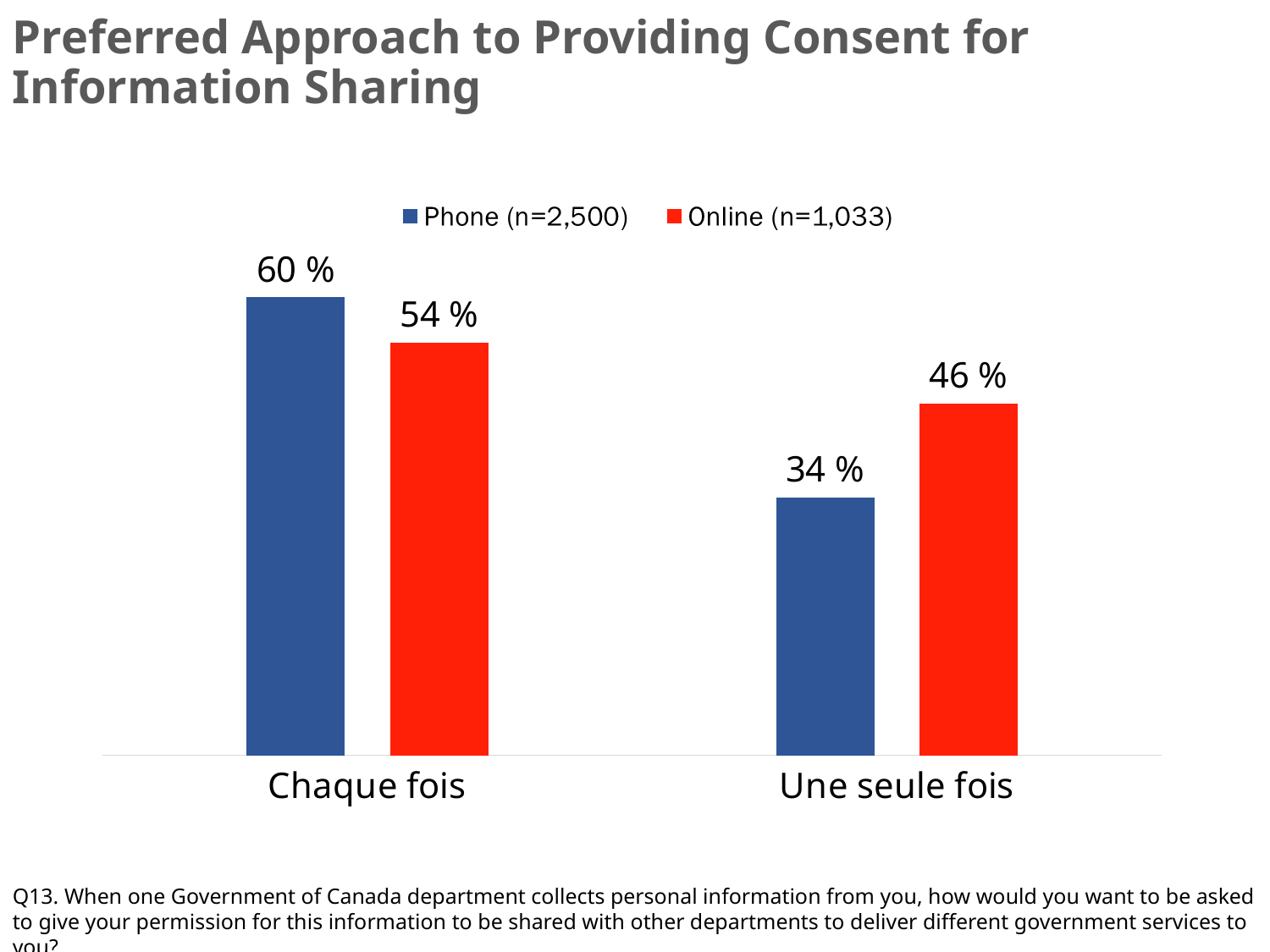
For Une seule fois, which is larger: the Phone value or the Online value? Online How many categories are shown on the x axis? 2 What is the Phone value for Une seule fois? 34 % What kind of chart is shown on the slide? Bar chart What is the Phone value for Chaque fois? 60 % What is the Online value for Chaque fois? 54 % Which category has the lowest Online value? Une seule fois How many series does the legend list? 2 Which category has the highest Phone value? Chaque fois What is the difference between the Phone and Online values for Chaque fois? 6 % What is the Online value for Une seule fois? 46 % What is the difference between the Online and Phone values for Une seule fois? 12 %